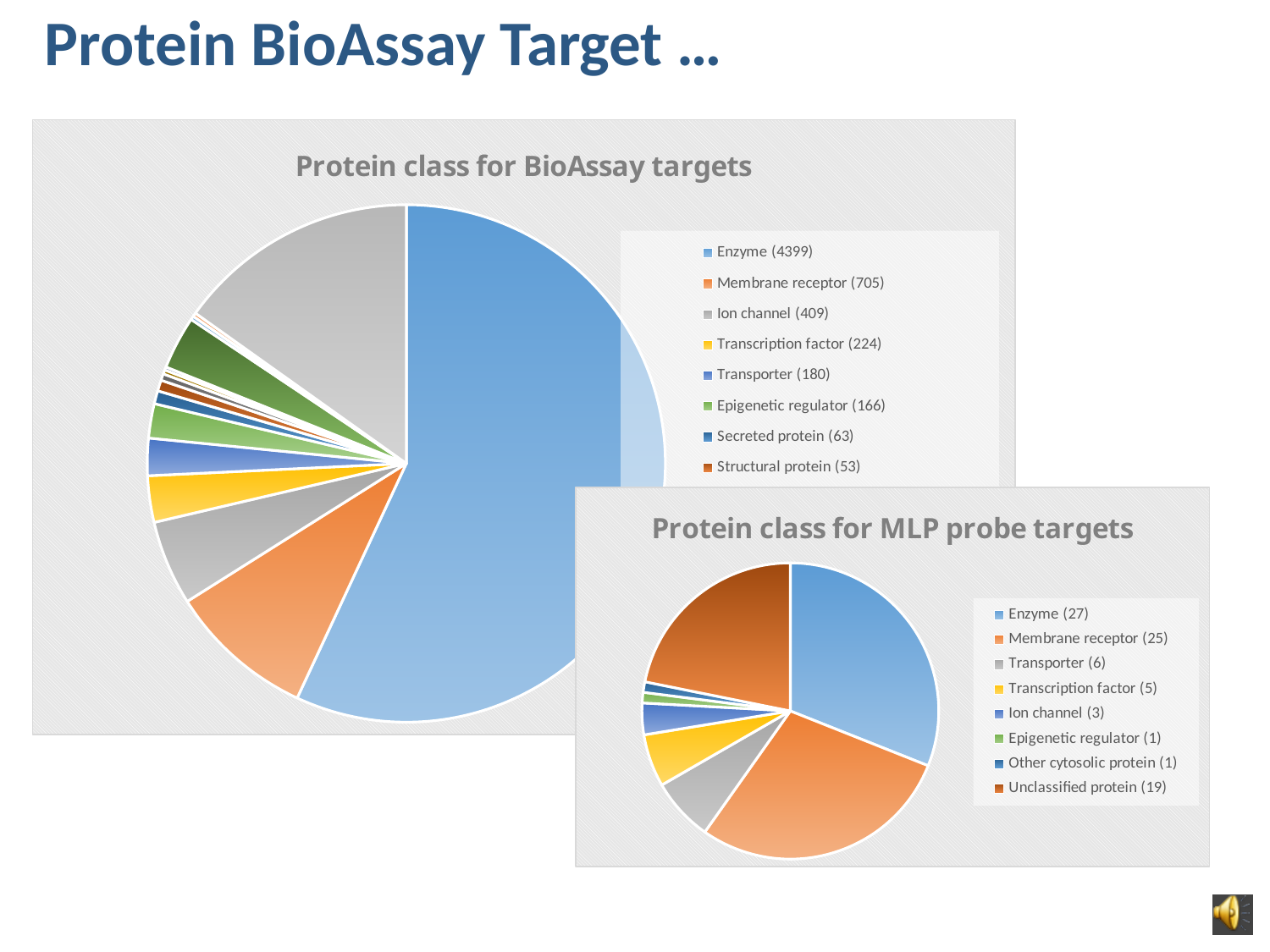
What is the title of the chart in the lower right of the slide? Protein class for MLP probe targets In the 'Protein class for MLP probe targets' chart, what is the difference between Unclassified protein and Transporter? 13 In the 'Protein class for BioAssay targets' chart, which is larger, Transcription factor or Transporter? Transcription factor In the 'Protein class for BioAssay targets' chart, which protein class has the highest value? Enzyme In the 'Protein class for BioAssay targets' chart, what is the difference between Enzyme and Membrane receptor? 3694 In the 'Protein class for MLP probe targets' chart, what is the value for Unclassified protein? 19 In the 'Protein class for BioAssay targets' chart, what is the value for Enzyme? 4399 In the 'Protein class for BioAssay targets' chart, what is the value for Ion channel? 409 How many protein classes are listed in the legend of the 'Protein class for MLP probe targets' chart? 8 In the 'Protein class for MLP probe targets' chart, which protein class has the highest value? Enzyme In the 'Protein class for MLP probe targets' chart, what is the value for Transporter? 6 What kind of chart is the 'Protein class for BioAssay targets' chart? pie chart